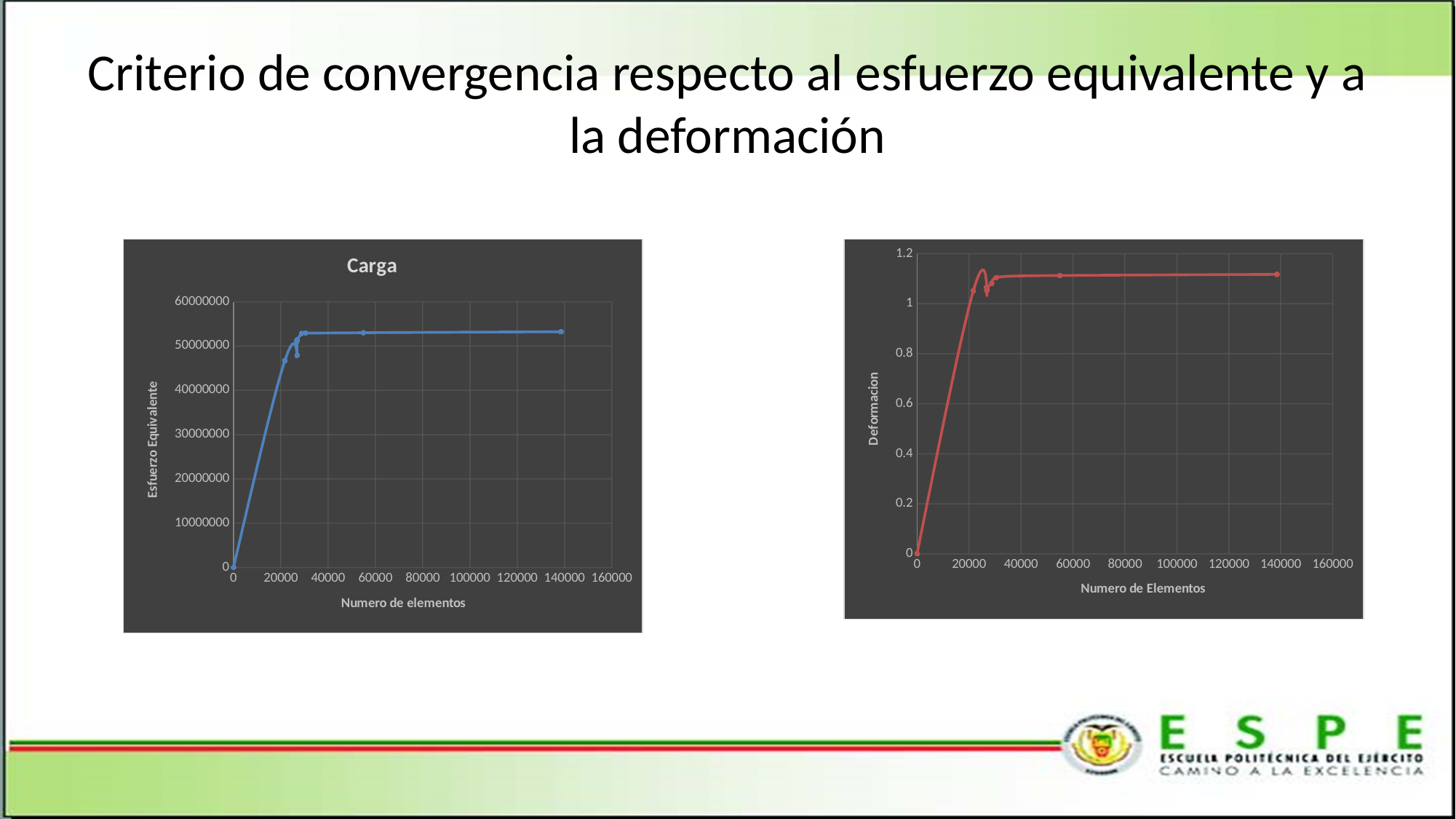
In the right chart, is the Deformacion value at about 140000 elements greater or less than 1.2? less What is the y-axis label of the right chart? Deformacion In the right chart, what is the Deformacion value at 0 elements? 0 In the left chart titled "Carga", is the Esfuerzo Equivalente value at about 140000 elements greater or less than 60000000? less What is the title of the left chart? Carga In the right chart, is the Deformacion value at about 140000 elements greater or less than 1? greater In the left chart titled "Carga", do the values rise or fall as the number of elements increases from 0? rise In the left chart titled "Carga", what is the Esfuerzo Equivalente value at 0 elements? 0 In the right chart, do the Deformacion values rise or fall as the number of elements increases from 0? rise What kind of chart is the right chart with the y-axis "Deformacion"? line chart What kind of chart is the left chart titled "Carga"? line chart